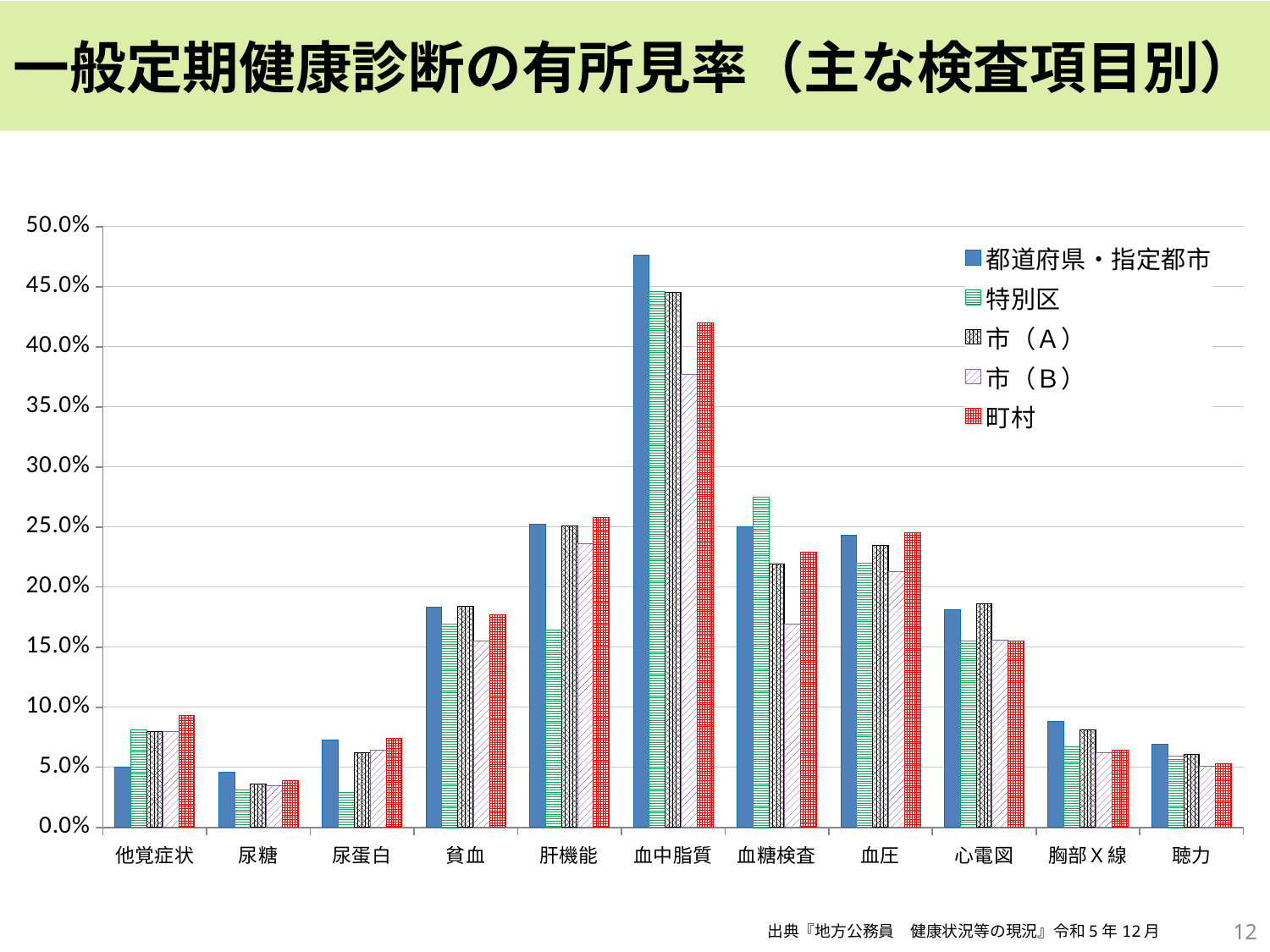
Within the 血中脂質 category, which series has the lowest value? 市（B） Is the value for 都道府県・指定都市 in 血中脂質 greater or less than 45.0%? greater How many categories are shown along the x axis? 11 In the 血糖検査 category, which is larger: 特別区 or 都道府県・指定都市? 特別区 Is the value for 市（B） in 血中脂質 greater or less than 40.0%? less Is the value for 特別区 in 血糖検査 greater or less than 25.0%? greater In the 肝機能 category, which is larger: 町村 or 特別区? 町村 What kind of chart is shown on the slide? bar chart How many series does the legend list? 5 Which category has the highest value for 都道府県・指定都市? 血中脂質 Which category has the lowest value for 町村? 尿糖 Within the 血中脂質 category, which series has the highest value? 都道府県・指定都市